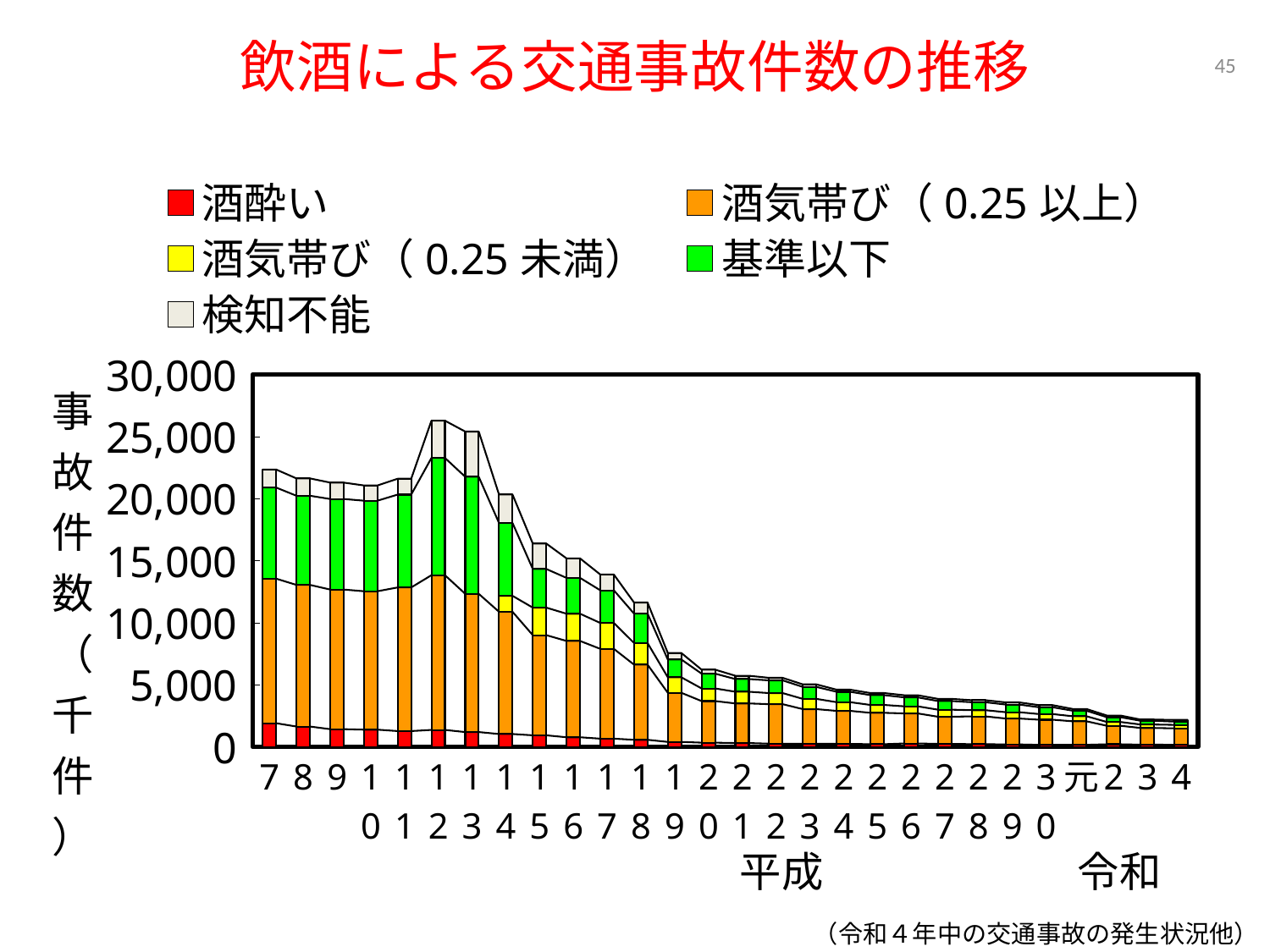
What is the title of the chart? 飲酒による交通事故件数の推移 Which year has the highest total number of accidents? 平成12 Is the total for 平成12 greater or less than 25,000? greater Is the total for 令和4 greater or less than 5,000? less What colour represents 酒酔い in the legend? Red Overall, do the total accident counts rise or fall from 平成7 to 令和4? Fall Is the 酒気帯び（0.25以上） segment for 平成12 greater or less than 10,000? greater How many series does the legend list? 5 What kind of chart is shown on the slide? Stacked bar chart How many bars (years) are plotted on the x axis? 28 Which has a larger total, 平成7 or 平成30? 平成7